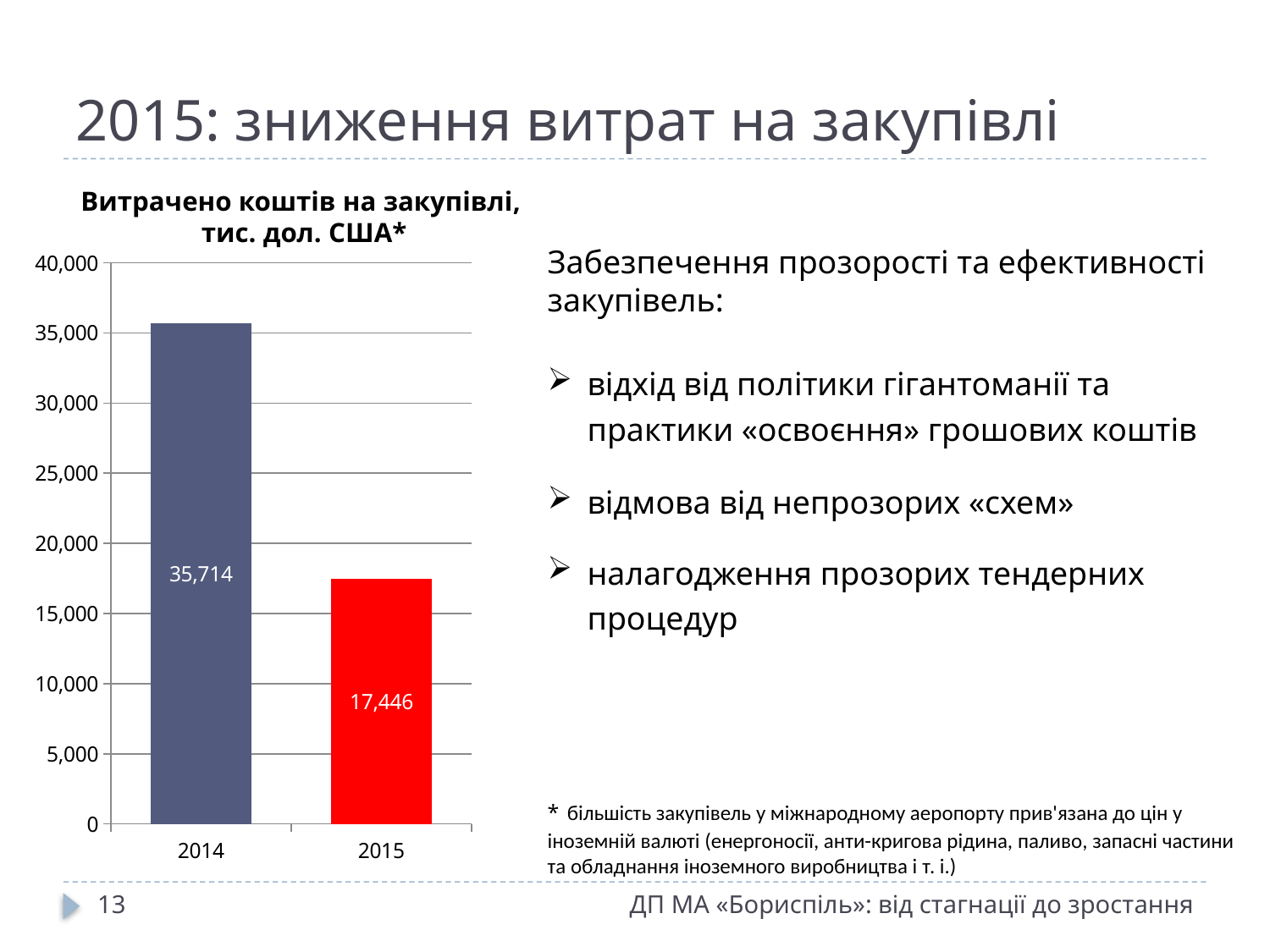
How many years are shown in the chart? 2 Which year has the lowest value in the chart? 2015 Is the value for 2015 greater or less than 20,000? less What type of chart is shown on the slide? bar chart Is the value for 2014 greater or less than 30,000? greater Do the values rise or fall from 2014 to 2015? fall Which year has the highest value in the chart? 2014 What is the title of the chart? Витрачено коштів на закупівлі, тис. дол. США* What was the value for 2015 in the chart? 17,446 What was the value for 2014 in the chart? 35,714 What is the difference between the 2014 and 2015 values? 18,268 Which is larger, the value for 2014 or the value for 2015? 2014